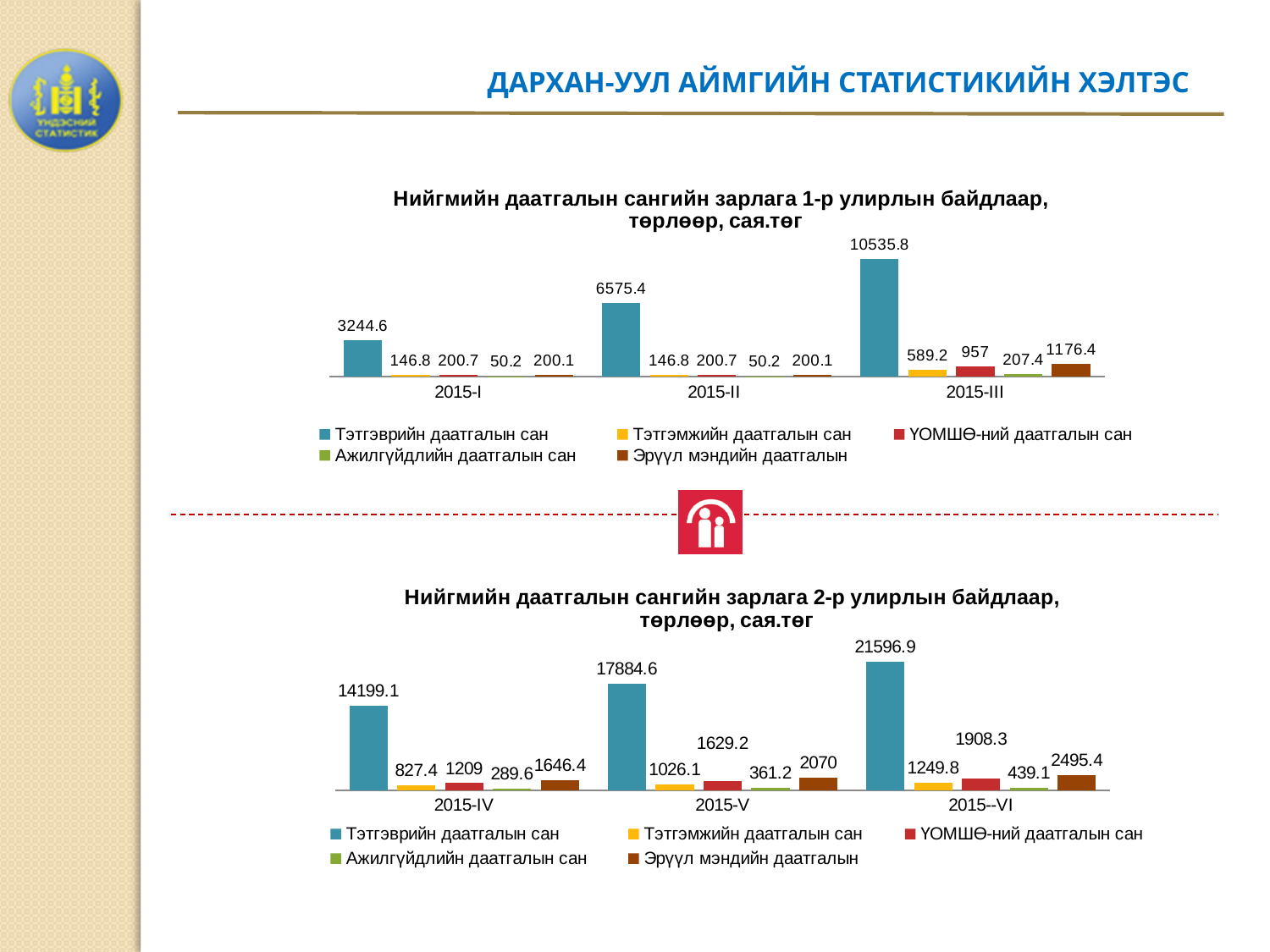
In the top chart (1-р улирлын байдлаар), which category has the highest value for Тэтгэврийн даатгалын сан? 2015-III In the top chart (1-р улирлын байдлаар), what is the value of Эрүүл мэндийн даатгалын for 2015-III? 1176.4 In the bottom chart (2-р улирлын байдлаар), what is the value of Тэтгэврийн даатгалын сан for 2015-V? 17884.6 In the top chart (1-р улирлын байдлаар), does the Тэтгэврийн даатгалын сан value rise or fall from 2015-I to 2015-III? rise In the top chart (1-р улирлын байдлаар), what is the value of Тэтгэврийн даатгалын сан for 2015-III? 10535.8 In the bottom chart (2-р улирлын байдлаар), which is larger: Эрүүл мэндийн даатгалын for 2015-V or ҮОМШӨ-ний даатгалын сан for 2015-V? Эрүүл мэндийн даатгалын What kind of chart is the bottom chart (2-р улирлын байдлаар)? bar chart In the bottom chart (2-р улирлын байдлаар), what is the value of ҮОМШӨ-ний даатгалын сан for 2015--VI? 1908.3 In the top chart (1-р улирлын байдлаар), how many series does the legend list? 5 In the top chart (1-р улирлын байдлаар), what is the difference between the Тэтгэврийн даатгалын сан values for 2015-II and 2015-I? 3330.8 In the bottom chart (2-р улирлын байдлаар), which series has the lowest value for 2015-IV? Ажилгүйдлийн даатгалын сан In the bottom chart (2-р улирлын байдлаар), how many categories are shown on the x axis? 3